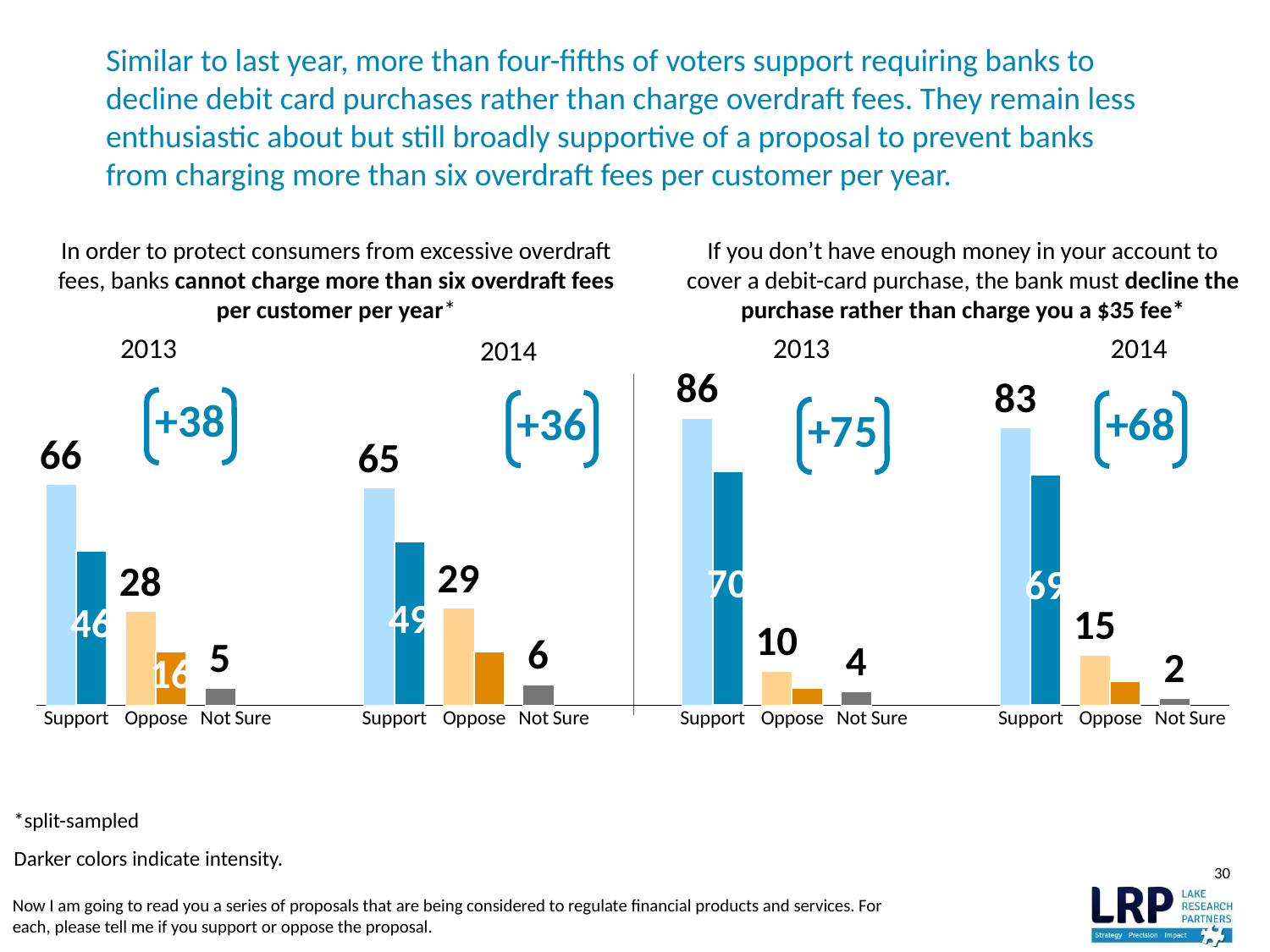
In the right chart (decline the purchase rather than charge a $35 fee), what is the Not Sure value for 2014? 2 In the right chart (decline the purchase rather than charge a $35 fee), what percentage of voters supported the proposal in 2013? 86 In the left chart (six overdraft fees per customer per year), what percentage of voters supported the proposal in 2013? 66 According to the note on the slide, what do the darker colors in the bars indicate? Intensity What kind of chart is used on this slide to show the survey results? Bar chart In the right chart (decline the purchase rather than charge a $35 fee), which is larger: Oppose in 2013 or Oppose in 2014? Oppose in 2014 In the left chart (six overdraft fees per customer per year), what percentage of voters opposed the proposal in 2014? 29 In the right chart (decline the purchase rather than charge a $35 fee), by how much did Support fall from 2013 to 2014? 3 In the left chart (six overdraft fees per customer per year), what is the difference between Support and Oppose in 2013? 38 In the left chart (six overdraft fees per customer per year), which response category has the lowest value in 2014? Not Sure In the right chart (decline the purchase rather than charge a $35 fee), what is the net support figure shown in brackets for 2014? +68 In the right chart (decline the purchase rather than charge a $35 fee), which response category has the highest value in 2013? Support